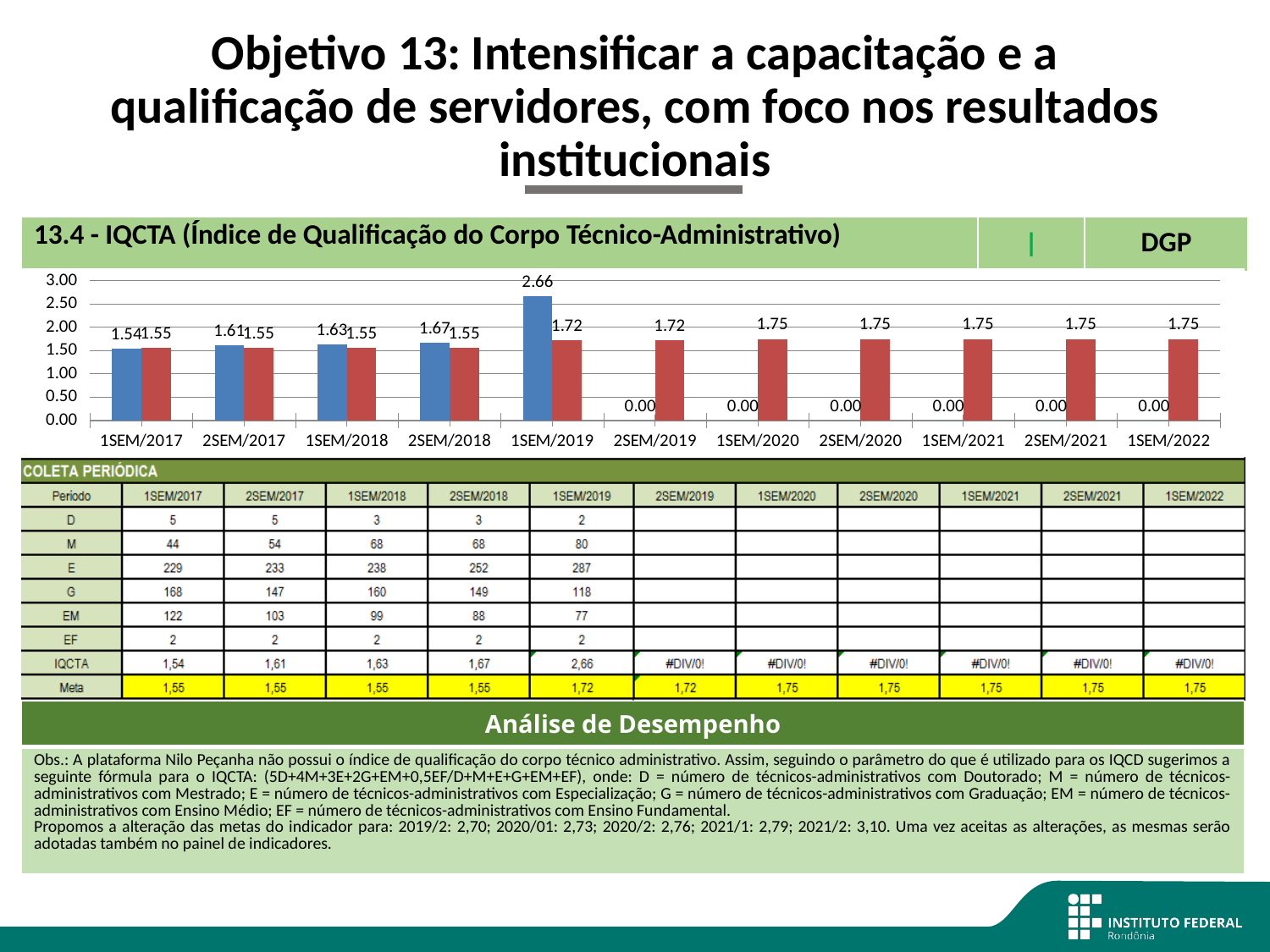
How many periods show a blue bar value of 0.00? 6 How many periods are shown along the x axis of the chart? 11 Which period has the highest blue bar? 1SEM/2019 Is the value of the blue bar for 1SEM/2019 greater or less than 2.50? greater What is the value of the blue bar for 1SEM/2019? 2.66 What is the difference between the red bar for 1SEM/2022 and the red bar for 1SEM/2017? 0.20 Do the blue bars rise or fall from 1SEM/2017 to 1SEM/2019? rise What is the value of the red bar for 2SEM/2018? 1.55 What is the difference between the blue bar and the red bar for 1SEM/2019? 0.94 What is the value of the red bar for 1SEM/2022? 1.75 For 1SEM/2017, which is larger: the blue bar or the red bar? the red bar What kind of chart is shown on the slide? bar chart